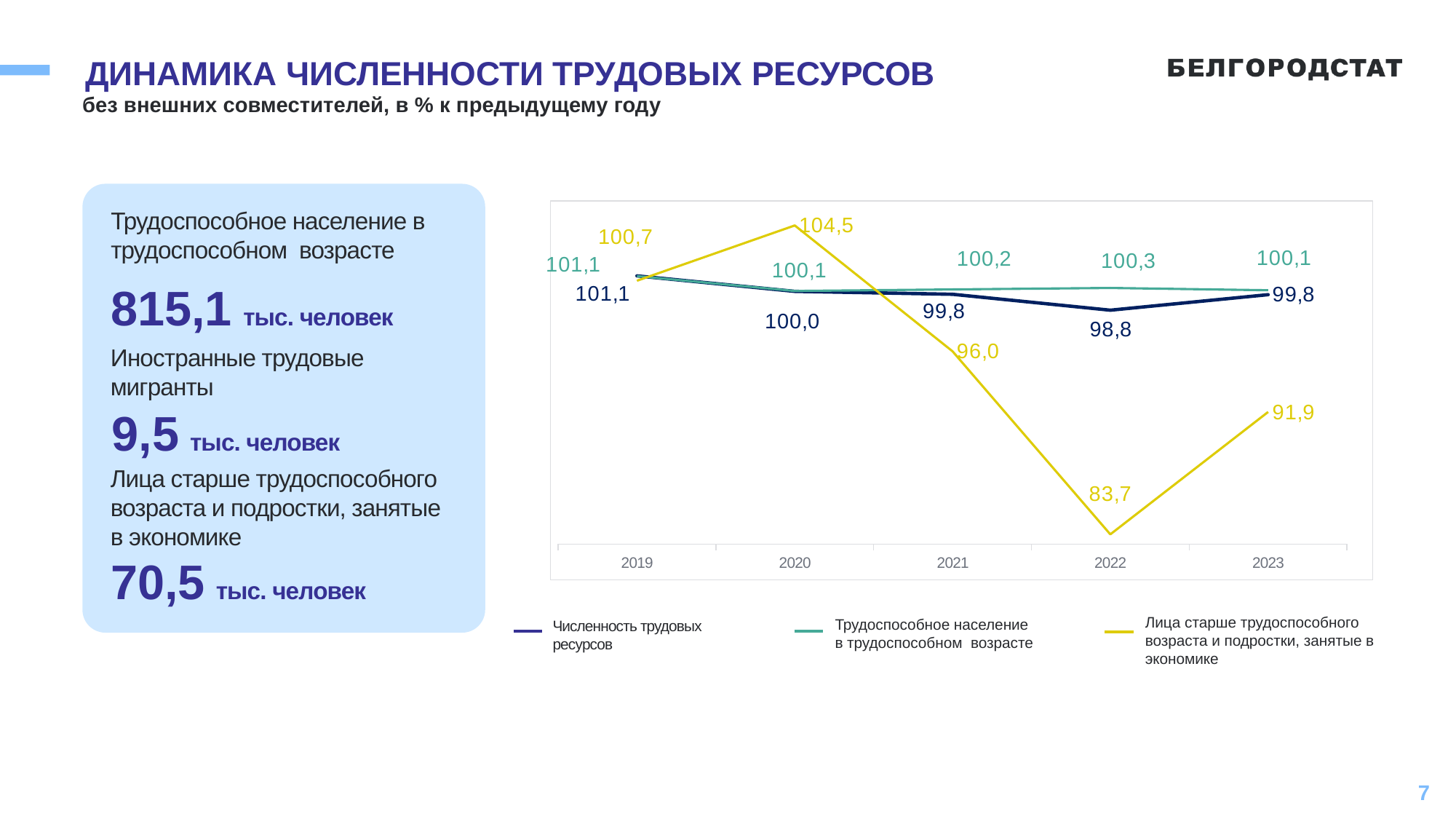
What is the value of the series 'Трудоспособное население в трудоспособном возрасте' in 2023? 100,1 How many years are shown on the x axis of the chart? 5 In which year does the series 'Лица старше трудоспособного возраста и подростки, занятые в экономике' reach its lowest value? 2022 How many series does the chart legend list? 3 What type of chart is shown on the slide? Line chart What is the value of the series 'Лица старше трудоспособного возраста и подростки, занятые в экономике' in 2020? 104,5 Does the series 'Численность трудовых ресурсов' rise or fall from 2019 to 2022? Fall What colour is the line for the series 'Лица старше трудоспособного возраста и подростки, занятые в экономике'? Yellow What is the value of the series 'Численность трудовых ресурсов' in 2022? 98,8 Which series has the larger value in 2021: 'Численность трудовых ресурсов' or 'Лица старше трудоспособного возраста и подростки, занятые в экономике'? Численность трудовых ресурсов In which year does the series 'Лица старше трудоспособного возраста и подростки, занятые в экономике' reach its highest value? 2020 What is the difference between the 2020 and 2022 values of the series 'Лица старше трудоспособного возраста и подростки, занятые в экономике'? 20,8